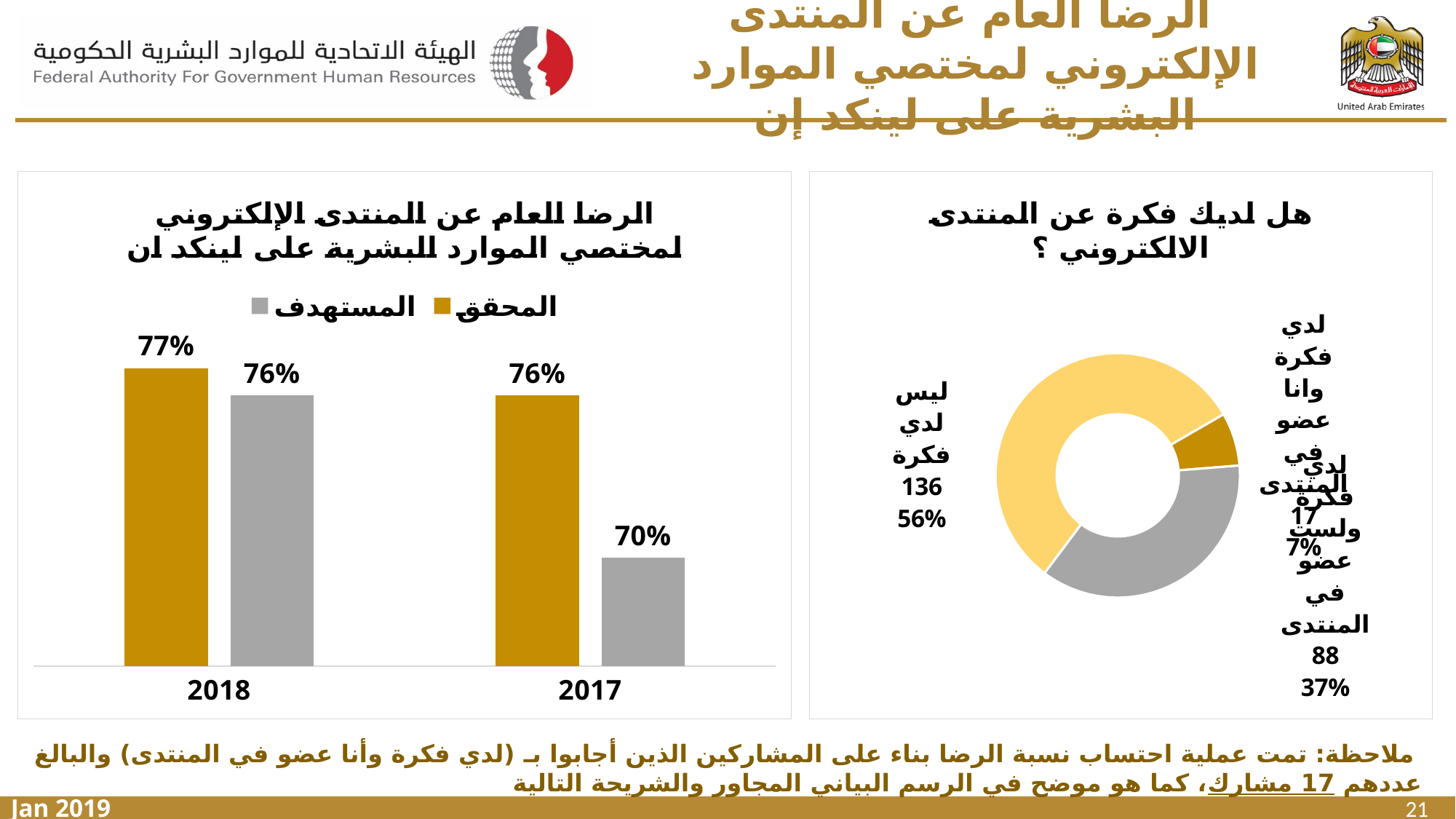
In the donut chart on the right, which answer has the smallest share? لدي فكرة وانا عضو في المنتدى In the bar chart on the left, how many series does the legend list? 2 In the donut chart on the right, how many respondents answered لدي فكرة وانا عضو في المنتدى? 17 What type of chart is the chart on the left? bar chart In the donut chart on the right, what share of respondents answered ليس لدي فكرة? 56% In the bar chart on the left, what is the value of المحقق for 2017? 76% In the bar chart on the left, what is the value of المحقق for 2018? 77% In the bar chart on the left, how many year categories are shown on the x axis? 2 In the bar chart on the left, what is the difference between المحقق and المستهدف for 2017? 6% In the bar chart on the left, what is the value of المستهدف for 2017? 70% In the donut chart on the right, what is the count for لدي فكرة ولست عضو في المنتدى? 88 In the bar chart on the left, which is larger for 2018: المحقق or المستهدف? المحقق